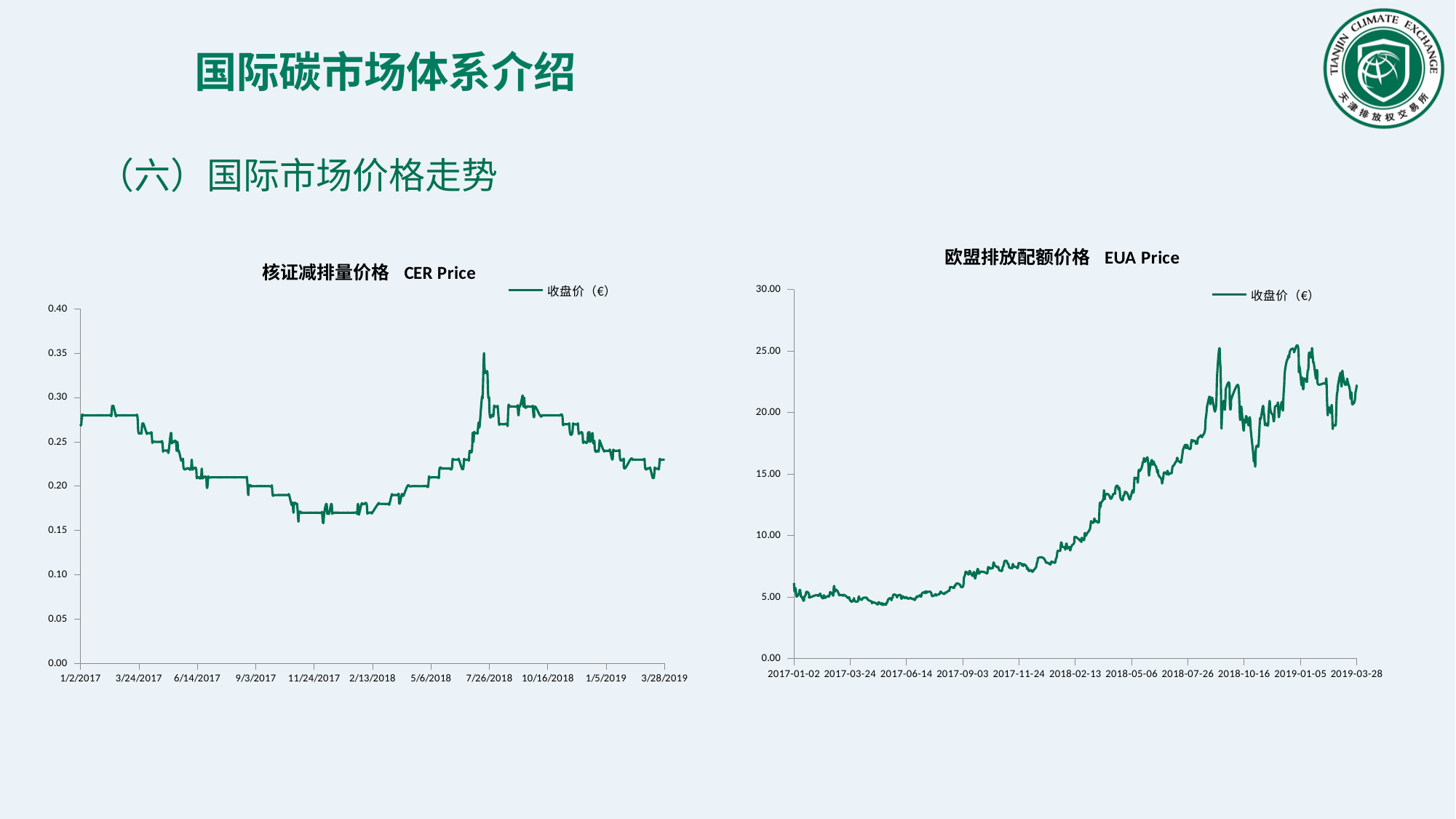
In the EUA Price chart, which is larger: the value at 2017-01-02 or the value at 2019-03-28? 2019-03-28 In the CER Price chart, is the value at 1/2/2017 greater or less than 0.25? greater How many series does the legend of the EUA Price chart list? 1 What kind of chart is the CER Price chart on the left? line chart In the EUA Price chart, is the value at 2018-02-13 greater or less than 15.00? less What kind of chart is the EUA Price chart on the right? line chart What is the legend entry shown on the CER Price chart? 收盘价（€） What is the title of the chart on the right? 欧盟排放配额价格 EUA Price In the CER Price chart, is the value around 11/24/2017 greater or less than 0.20? less In the EUA Price chart, do values overall rise or fall from 2017-01-02 to 2019-03-28? rise